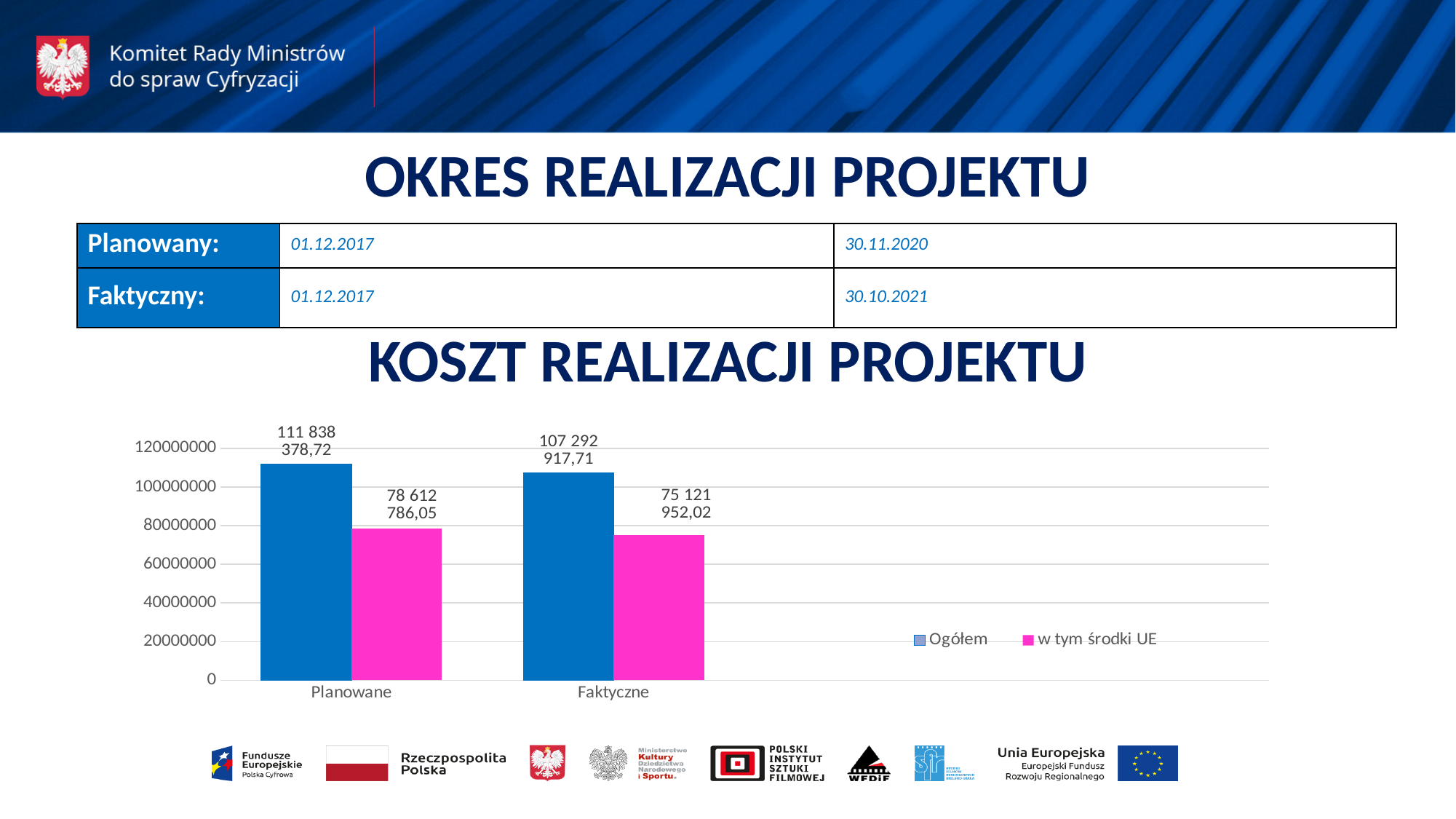
What is the value of w tym środki UE for Planowane? 78 612 786,05 Which bar in the chart is the lowest? w tym środki UE for Faktyczne What is the value of Ogółem for Faktyczne? 107 292 917,71 What is the value of w tym środki UE for Faktyczne? 75 121 952,02 Is the value of w tym środki UE for Planowane greater or less than 80000000? less What is the value of Ogółem for Planowane? 111 838 378,72 What is the difference between the Ogółem values for Planowane and Faktyczne? 4 545 461,01 What type of chart is shown under KOSZT REALIZACJI PROJEKTU? bar chart Which category has the higher Ogółem value, Planowane or Faktyczne? Planowane How many categories are shown on the x axis of the chart? 2 How many series does the chart legend list? 2 What is the difference between Ogółem and w tym środki UE for Faktyczne? 32 170 965,69